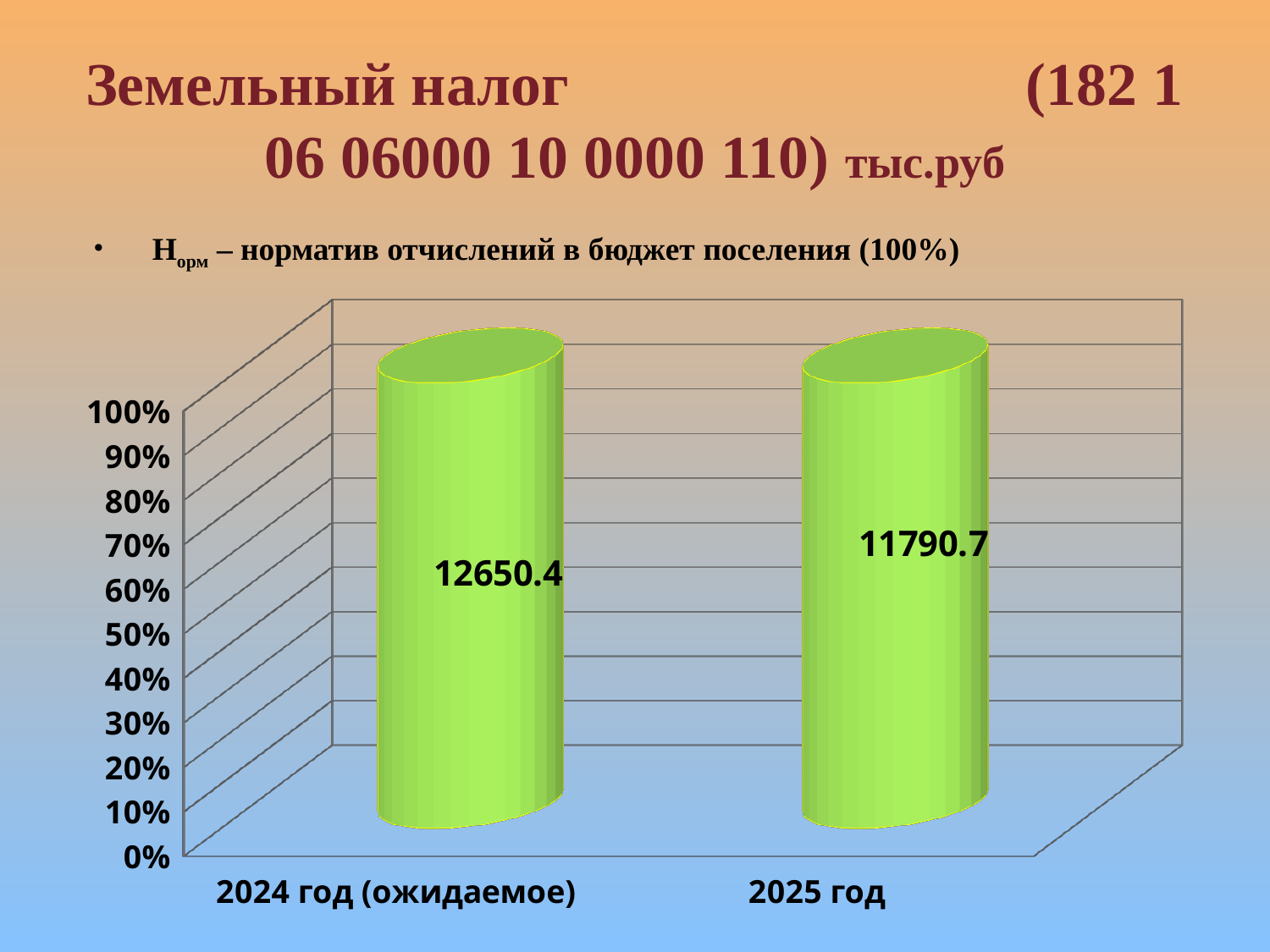
Which category has the higher labelled value? 2024 год (ожидаемое) How many categories are shown on the x axis? 2 What is the difference between the values for 2024 год (ожидаемое) and 2025 год? 859.7 Do the labelled values rise or fall from 2024 год (ожидаемое) to 2025 год? fall What kind of chart is shown on the slide? bar chart Which category has the lower labelled value? 2025 год Is the value for 2025 год larger or smaller than the value for 2024 год (ожидаемое)? smaller What is the value shown for 2025 год? 11790.7 What is the highest tick label on the vertical axis? 100% What is the value shown for 2024 год (ожидаемое)? 12650.4 What unit is stated in the slide title for the values? тыс.руб